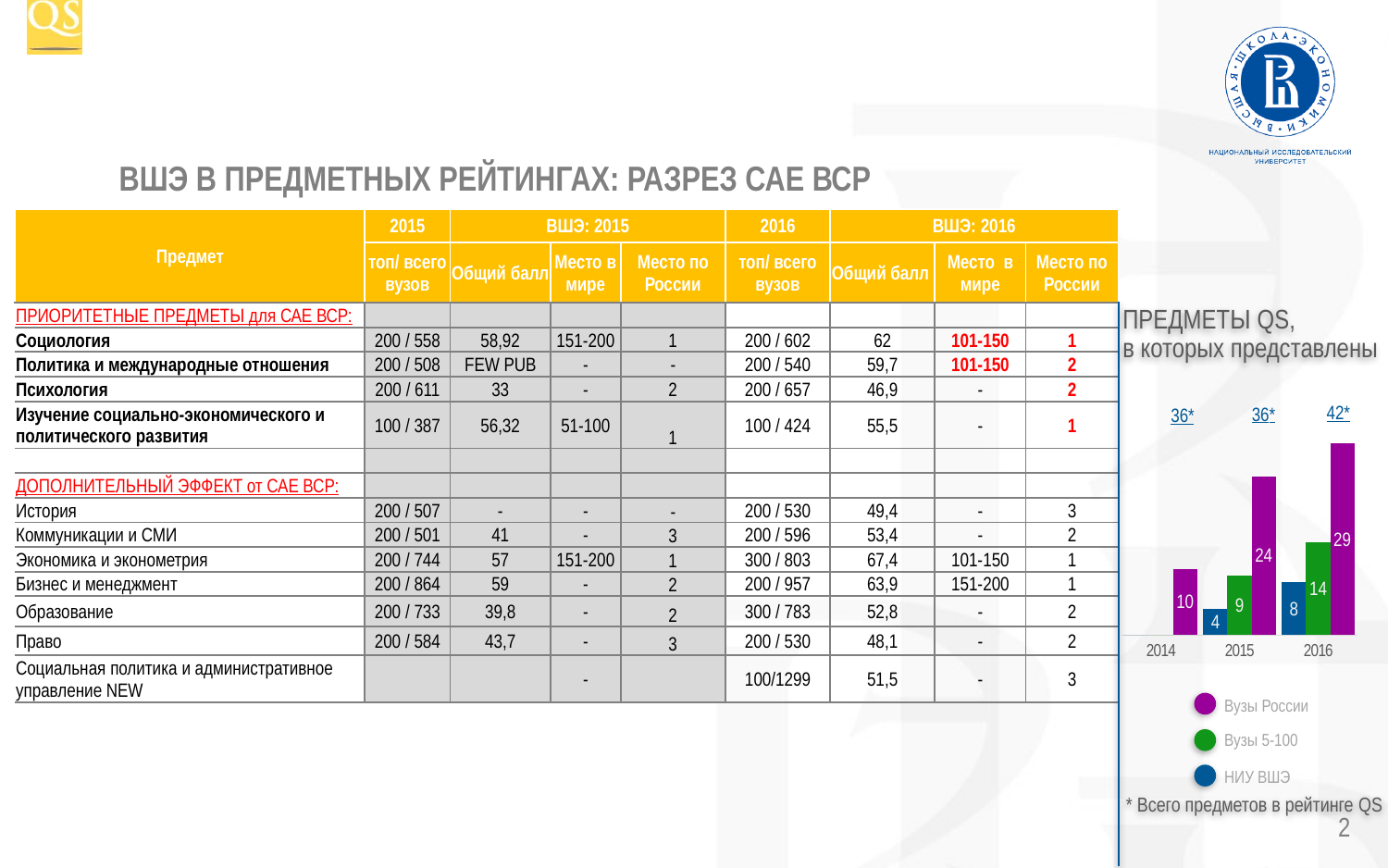
In the bar chart, what is the value for Вузы России in 2015? 24 How many series does the legend of the bar chart list? 3 In the bar chart, which year has the highest value for Вузы России? 2016 How many years are shown on the x axis of the bar chart? 3 In the bar chart, which year has the lowest value for Вузы России? 2014 In the bar chart, does the value for Вузы России rise or fall from 2014 to 2016? rise In the bar chart, what is the difference between the Вузы России values for 2016 and 2014? 19 In the bar chart, what is the value for Вузы России in 2014? 10 In the bar chart, what is the value for Вузы России in 2016? 29 What total number of subjects in the QS ranking is printed above the 2016 group of bars? 42* What kind of chart is shown on the right side of the slide? bar chart In the bar chart, which is larger: the Вузы России value for 2015 or for 2016? 2016